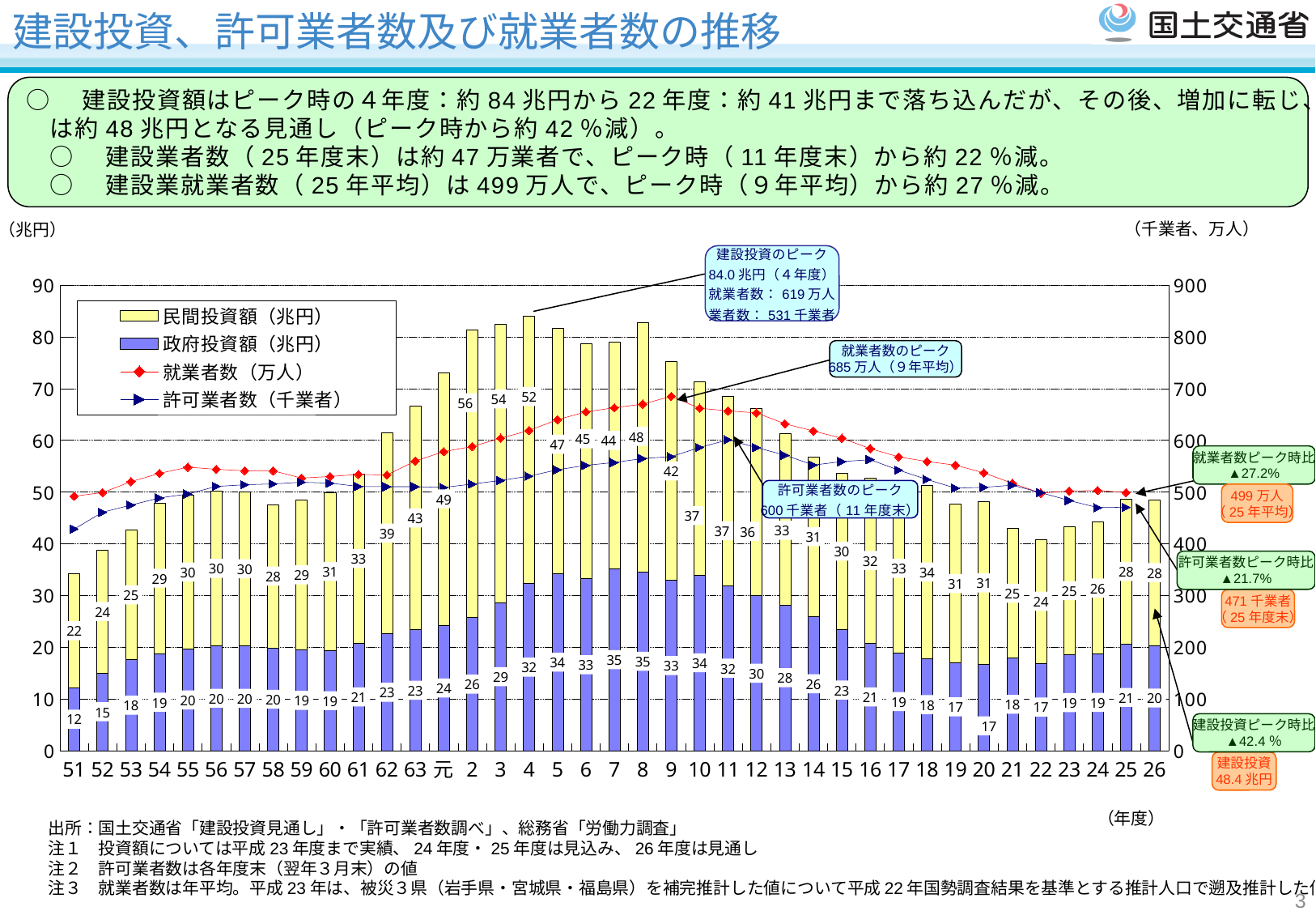
What is the total of the stacked bar (民間投資額 plus 政府投資額) for fiscal year 51? 34 What is the difference between 民間投資額 in fiscal year 2 and in fiscal year 26? 28 In which fiscal year is 政府投資額 lowest? 51 How many series does the legend list? 4 Is the 就業者数 value for fiscal year 9 greater or less than 600 on the right axis? greater According to the annotation, what is the peak value of 許可業者数? 600千業者 According to the annotation, what is the peak value of 就業者数? 685万人 What is the 政府投資額 (兆円) value for fiscal year 7? 35 Which is larger, 民間投資額 in fiscal year 4 or in fiscal year 8? Fiscal year 4 In which fiscal year is 民間投資額 highest? 2 What kind of chart is shown on the slide? A combination chart of stacked bars and lines What is the 民間投資額 (兆円) value for fiscal year 51? 22